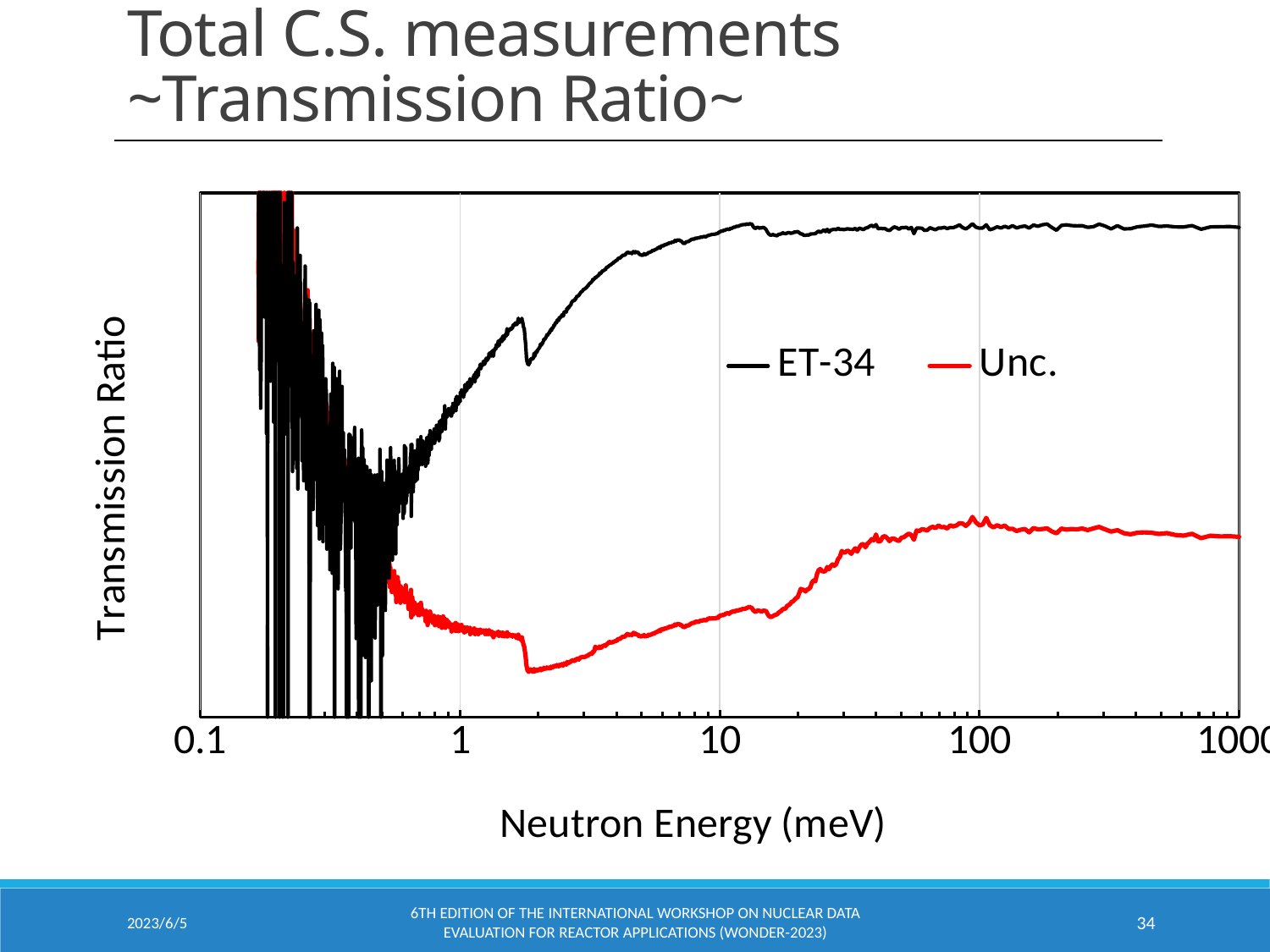
What is the lowest tick value shown on the x axis? 0.1 What is the label of the x axis? Neutron Energy (meV) How many series does the legend list? 2 At 100 meV, which series has the higher value, ET-34 or Unc.? ET-34 How many labelled tick values are there on the x axis? 5 Is the sharp dip in the ET-34 series located at a neutron energy greater or less than 10 meV? less What kind of chart is shown on the slide? Line chart Between 1 meV and 10 meV, does the ET-34 series generally rise or fall as neutron energy increases? Rise What are the two series named in the legend? ET-34 and Unc. What is the highest tick value shown on the x axis? 1000 What colour is the ET-34 series drawn in? Black What is the label of the y axis? Transmission Ratio